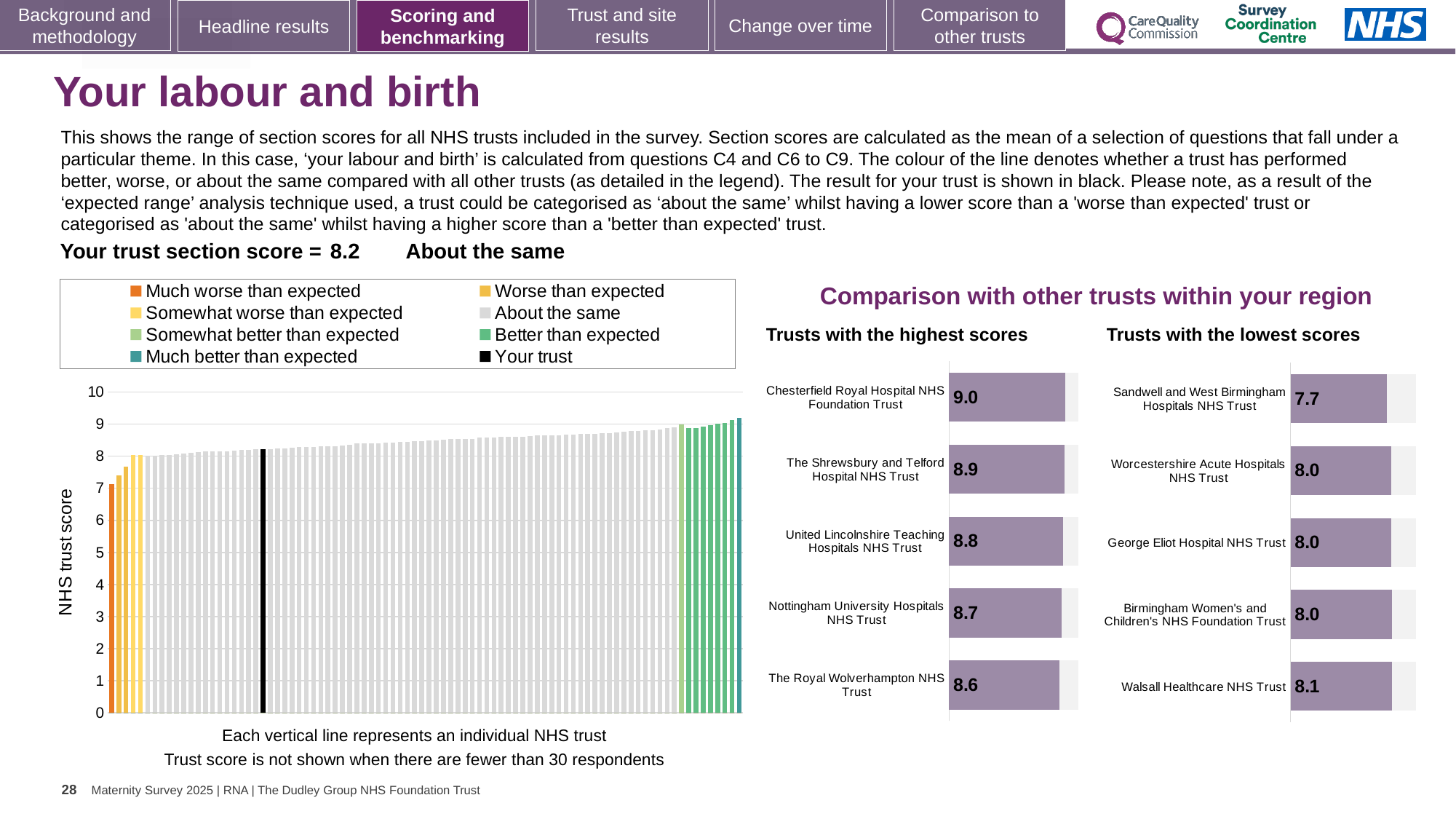
In the 'Trusts with the highest scores' chart, which trust has the highest score? Chesterfield Royal Hospital NHS Foundation Trust What is the label on the vertical axis of the main chart on the left? NHS trust score In the 'Trusts with the highest scores' chart, what is the score for Chesterfield Royal Hospital NHS Foundation Trust? 9.0 In the 'Trusts with the lowest scores' chart, which trust has the lowest score? Sandwell and West Birmingham Hospitals NHS Trust How many entries does the legend of the main 'NHS trust score' chart list? 8 In the 'Trusts with the lowest scores' chart, what is the score for Sandwell and West Birmingham Hospitals NHS Trust? 7.7 In the 'Trusts with the lowest scores' chart, what is the score for Walsall Healthcare NHS Trust? 8.1 In the main chart on the left, is the value of the black bar (your trust) greater or less than 5? greater In the 'Trusts with the highest scores' chart, what is the difference between the scores of Chesterfield Royal Hospital NHS Foundation Trust and The Royal Wolverhampton NHS Trust? 0.4 What kind of chart is the main chart on the left showing NHS trust scores? Bar chart In the 'Trusts with the lowest scores' chart, which has the larger score: Walsall Healthcare NHS Trust or Sandwell and West Birmingham Hospitals NHS Trust? Walsall Healthcare NHS Trust How many trusts are shown in the 'Trusts with the highest scores' chart? 5